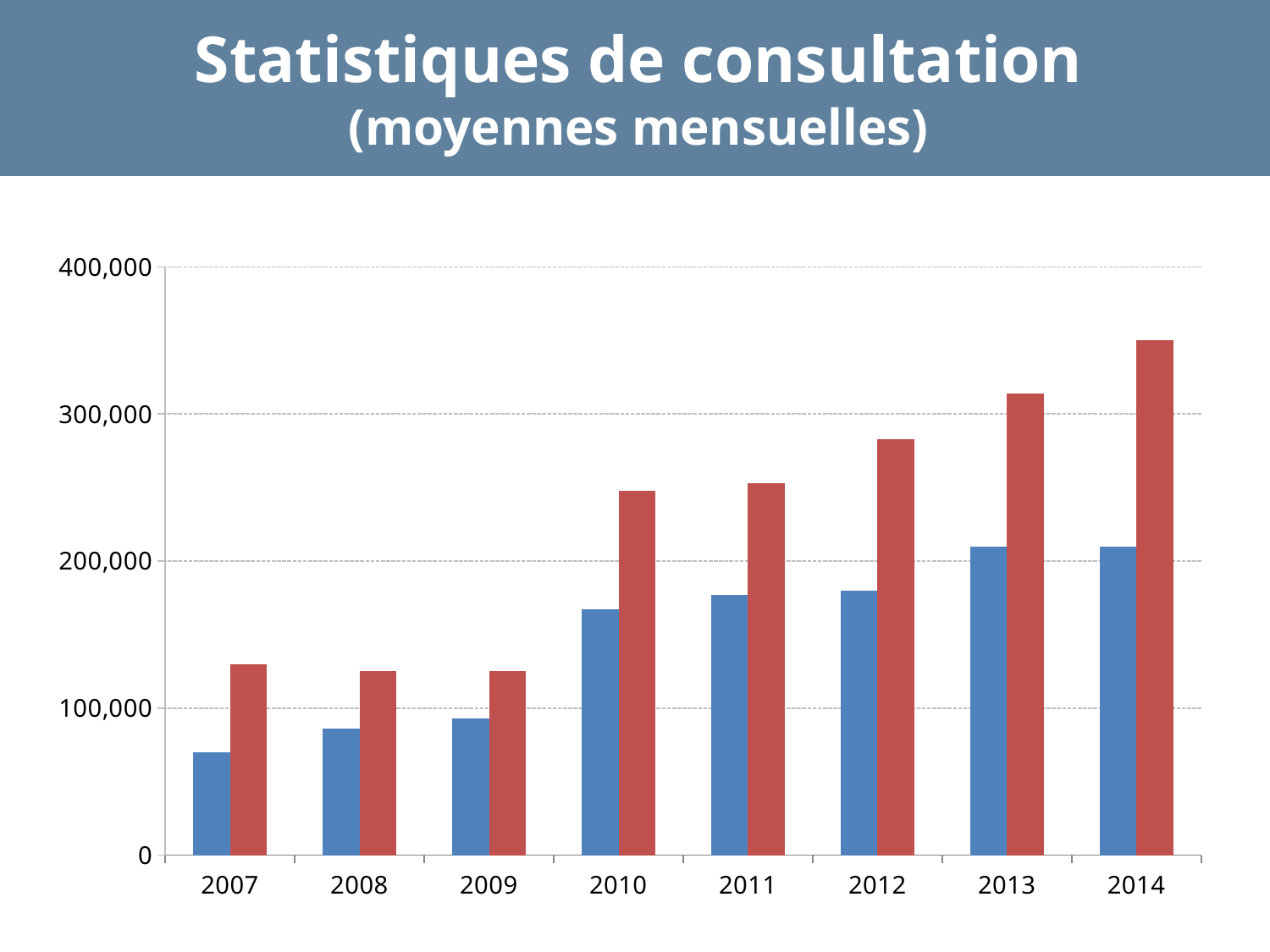
Is the value of the blue bar for 2007 greater or less than 100,000? less What is the title of the chart slide? Statistiques de consultation (moyennes mensuelles) Is the value of the red bar for 2014 greater or less than 300,000? greater How many bar colours (series) are plotted for each year? 2 What kind of chart is shown on the slide? bar chart Is the value of the blue bar for 2012 greater or less than 200,000? less How many years are shown on the x axis of the chart? 8 In which year is the blue bar the lowest? 2007 Do the red bars rise or fall from 2010 to 2014? rise For 2014, which bar is larger, the blue one or the red one? red In which year is the red bar the highest? 2014